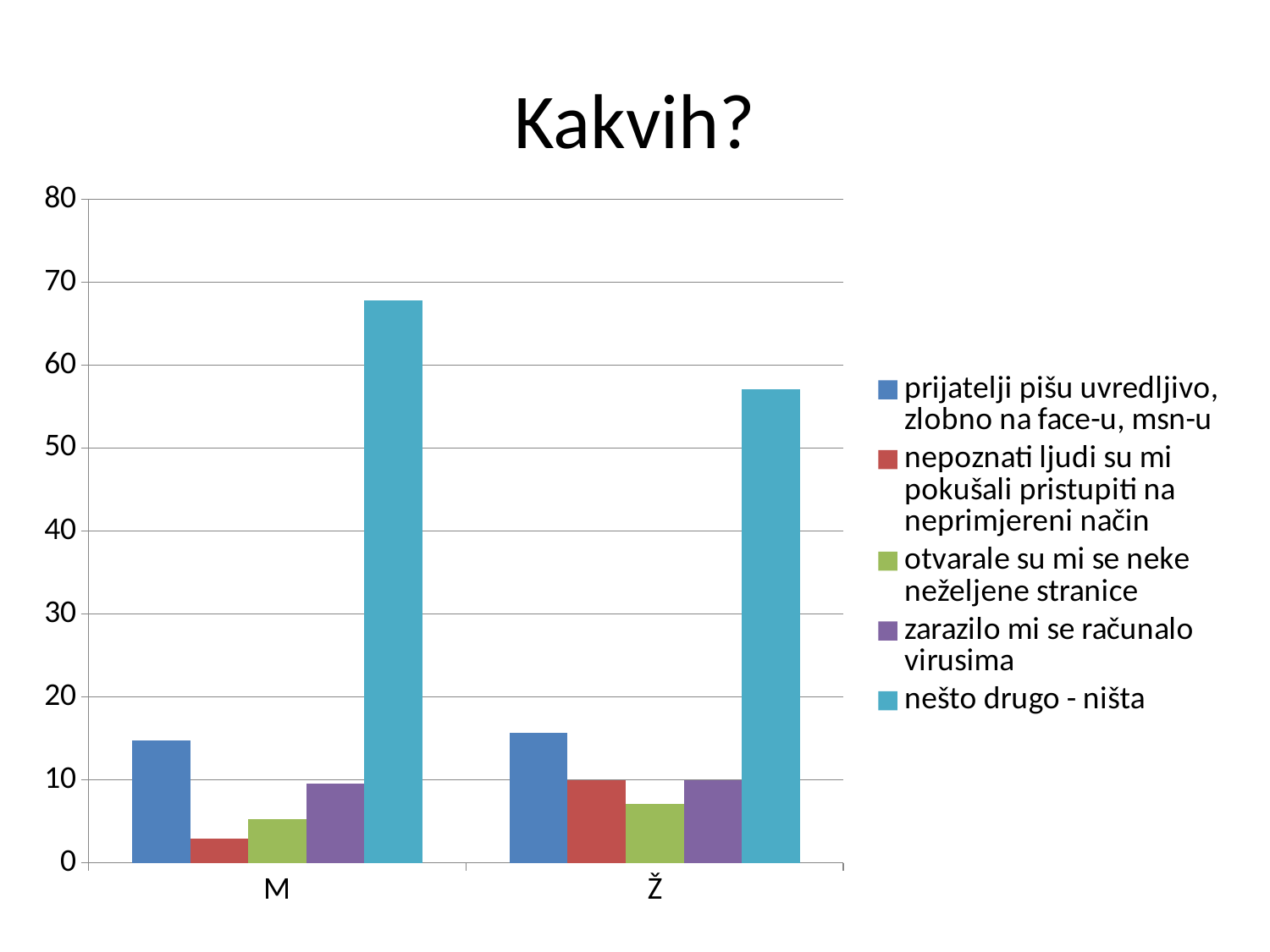
Is the value of 'nešto drugo - ništa' for M greater or less than 60? greater For category Ž, which series has the highest value? nešto drugo - ništa For category M, which series has the highest value? nešto drugo - ništa How many series does the legend list? 5 What is the title of the chart? Kakvih? Is the value of 'nešto drugo - ništa' for Ž greater or less than 60? less Is the value of 'nepoznati ljudi su mi pokušali pristupiti na neprimjereni način' for M greater or less than 10? less How many categories are shown on the x axis? 2 What kind of chart is shown on the slide? bar chart Which category has the larger value for 'nepoznati ljudi su mi pokušali pristupiti na neprimjereni način', M or Ž? Ž Which category has the larger value for 'nešto drugo - ništa', M or Ž? M For category M, which series has the lowest value? nepoznati ljudi su mi pokušali pristupiti na neprimjereni način